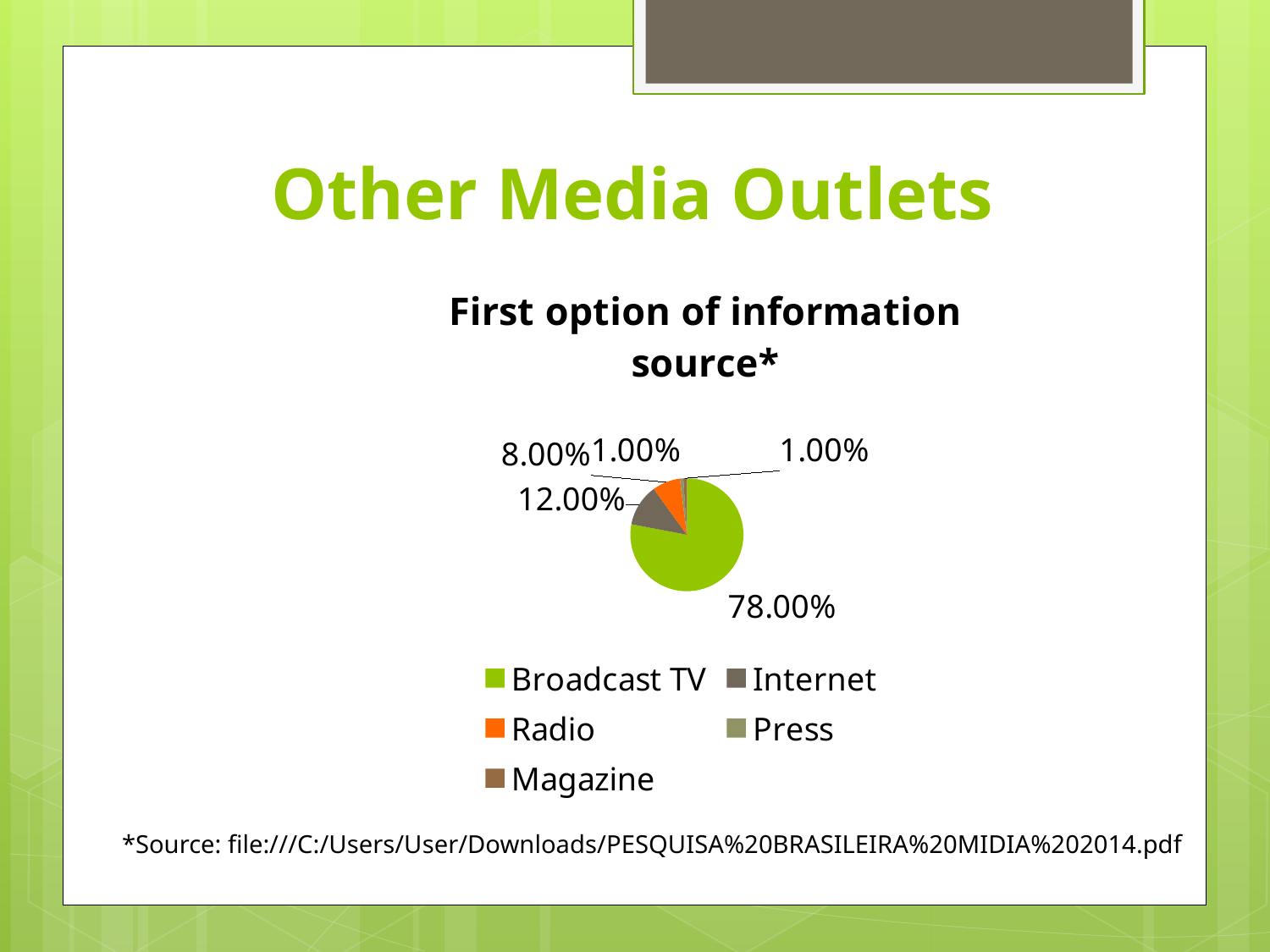
Which is larger, the Internet share or the Radio share? Internet What colour is the Radio slice? orange What share of the pie does Broadcast TV have? 78.00% What share of the pie does Internet have? 12.00% What kind of chart is shown on the slide? pie chart What share of the pie does Press have? 1.00% What share of the pie does Magazine have? 1.00% What is the difference between the Broadcast TV share and the Internet share? 66.00% What share of the pie does Radio have? 8.00% How many categories does the legend list? 5 Which category has the largest slice of the pie? Broadcast TV What is the title of the chart? First option of information source*